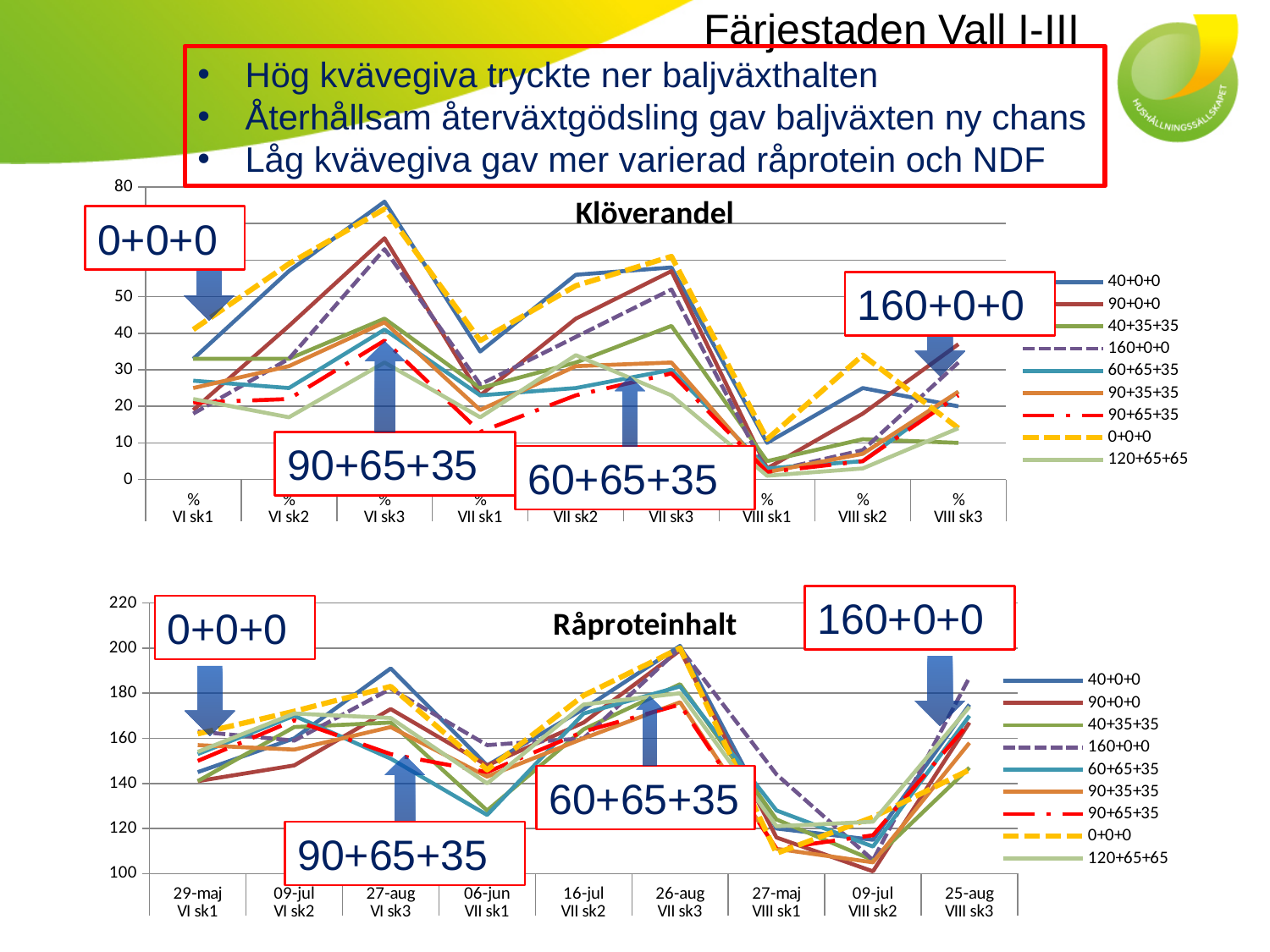
In the Råproteinhalt chart, is the value for 40+0+0 at 27-aug VI sk3 greater or less than 180? greater How many x-axis categories does the Klöverandel chart have? 9 How many series does the legend of the Klöverandel chart list? 9 In the Klöverandel chart, is the value for 40+0+0 at VI sk3 greater or less than 70? greater How many series does the legend of the Råproteinhalt chart list? 9 In the Klöverandel chart, do the values rise or fall from VII sk3 to VIII sk1? fall What kind of chart is the top chart titled Klöverandel? line chart In the Klöverandel chart, is the value for 90+0+0 at VIII sk1 greater or less than 10? less In the Klöverandel chart, which is larger at VI sk3: 40+0+0 or 120+65+65? 40+0+0 In the Råproteinhalt chart, do the values fall or rise from 26-aug VII sk3 to 09-jul VIII sk2? fall What kind of chart is the bottom chart titled Råproteinhalt? line chart